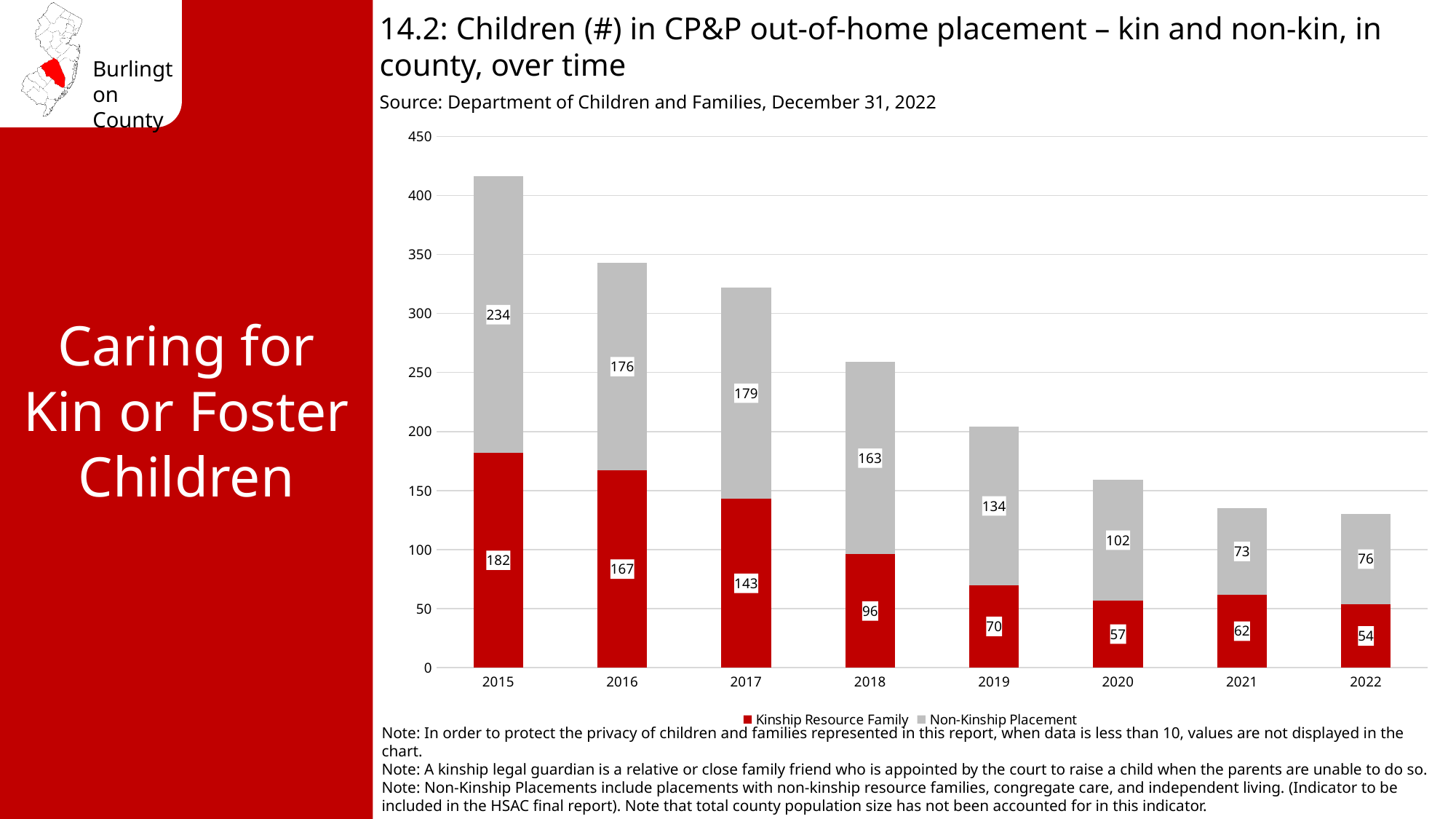
What is the Kinship Resource Family value for 2022? 54 Which is larger, the Kinship Resource Family value for 2020 or for 2021? 2021 What is the Non-Kinship Placement value for 2019? 134 Which year has the highest Non-Kinship Placement value? 2015 What is the difference between the Non-Kinship Placement values for 2016 and 2017? 3 How many years are shown on the x axis? 8 Is the total of the stacked bar for 2015 greater or less than 400? greater What is the total of the stacked bar for 2018? 259 How many series does the legend list? 2 Which year has the lowest Kinship Resource Family value? 2022 What is the Kinship Resource Family value for 2015? 182 What kind of chart is shown on the slide? Stacked bar chart